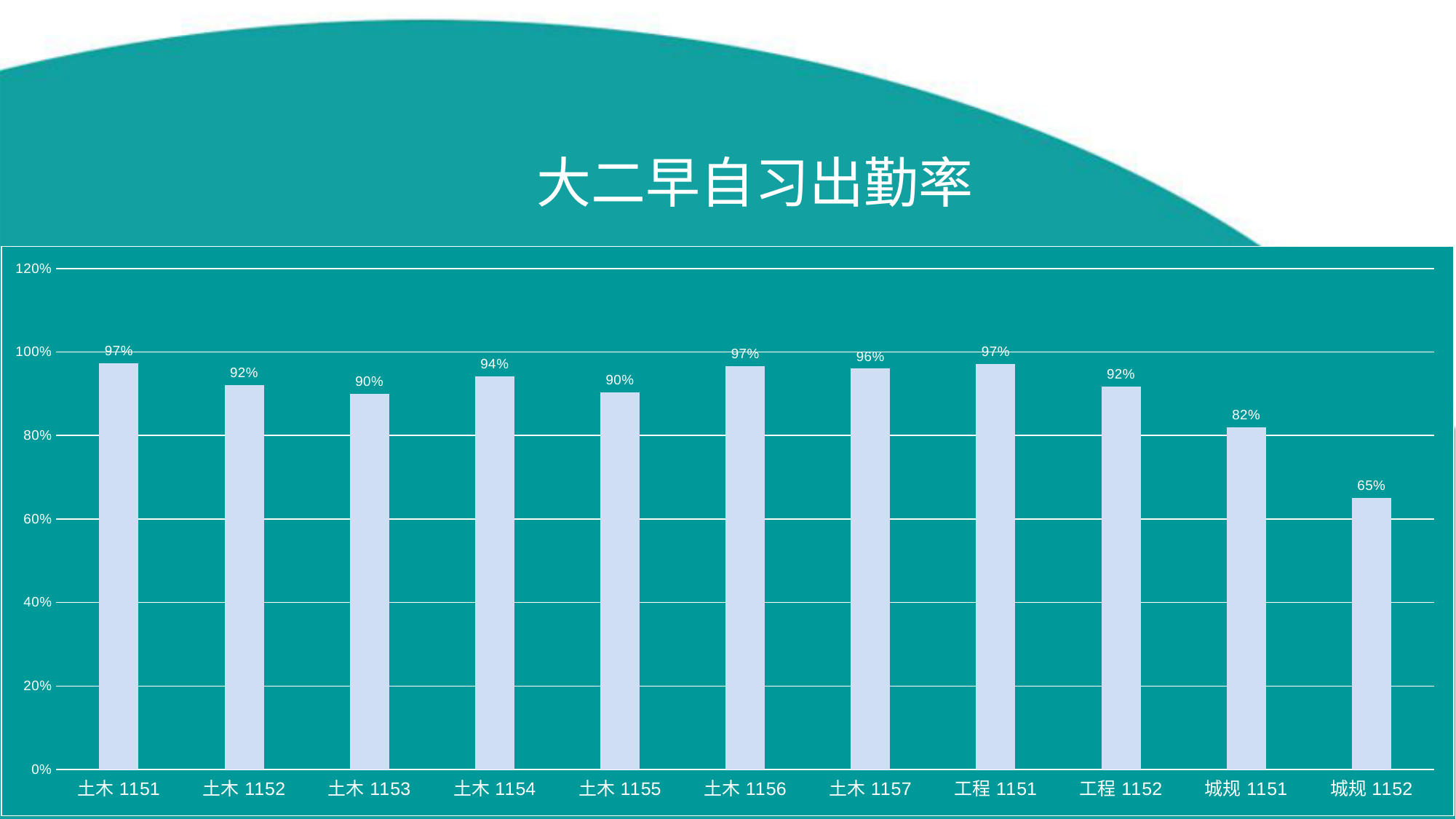
What is the difference between the attendance rates of 土木 1157 and 城规 1151? 14% Which has a higher attendance rate, 城规 1151 or 工程 1151? 工程 1151 What is the attendance rate for 城规 1151? 82% What is the title of the slide? 大二早自习出勤率 Is the value for 城规 1152 greater or less than 80%? less Which has a higher attendance rate, 土木 1152 or 土木 1153? 土木 1152 How many categories are shown on the x axis? 11 What is the attendance rate for 土木 1154? 94% What is the attendance rate for 工程 1152? 92% What kind of chart is shown on the slide? bar chart Which category has the lowest attendance rate? 城规 1152 What is the difference between the attendance rates of 土木 1151 and 城规 1152? 32%